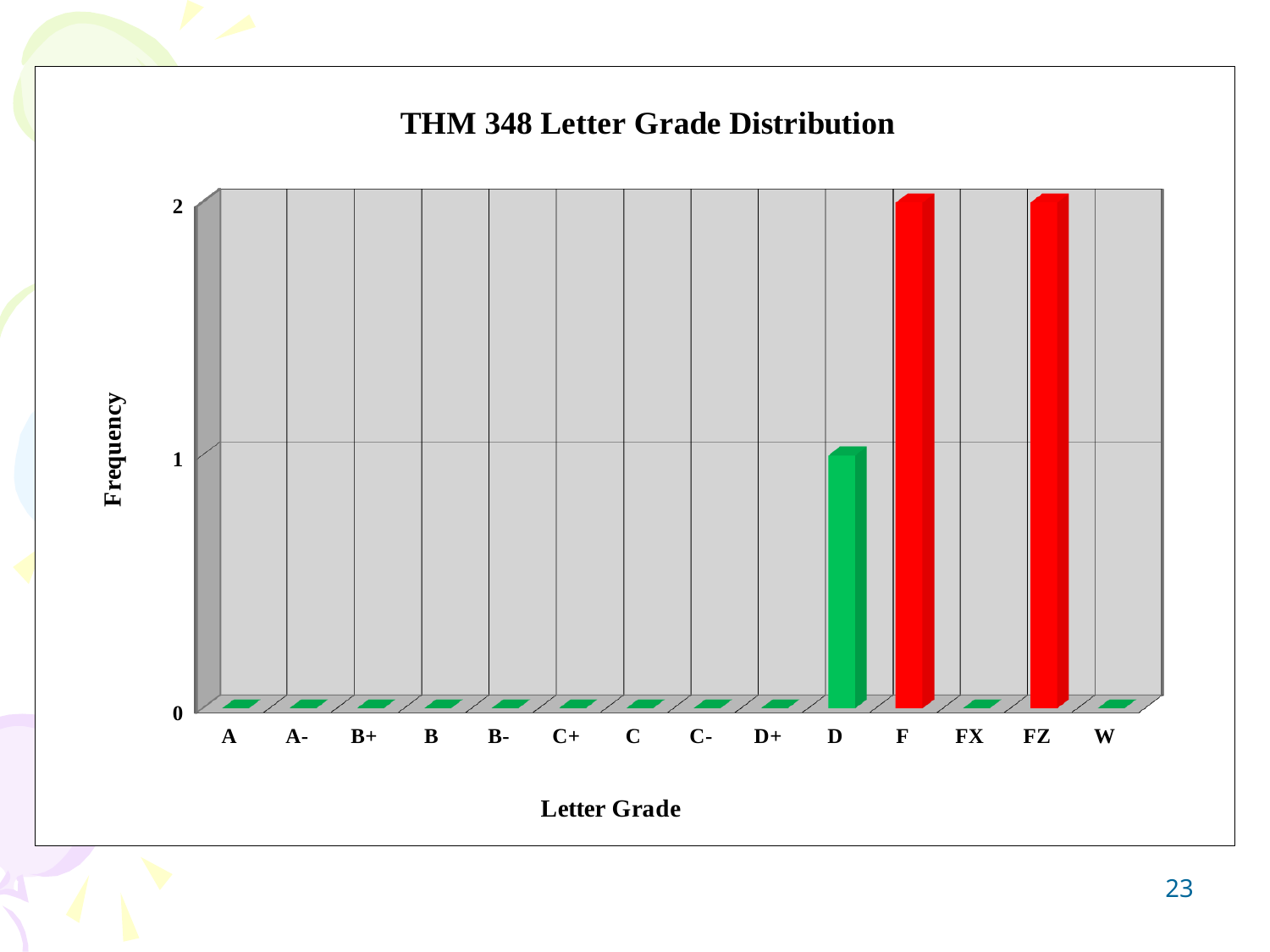
What is the difference in frequency between F and D? 1 What is the label of the y axis? Frequency What is the frequency for letter grade A? 0 What kind of chart is shown on the slide? bar chart What is the frequency for letter grade D? 1 What is the frequency for letter grade W? 0 What is the title of the chart? THM 348 Letter Grade Distribution Which letter grade has a higher frequency, D or F? F What is the frequency for letter grade F? 2 How many letter grade categories are shown on the x axis? 14 Which letter grade has a higher frequency, D or FX? D What is the frequency for letter grade FZ? 2